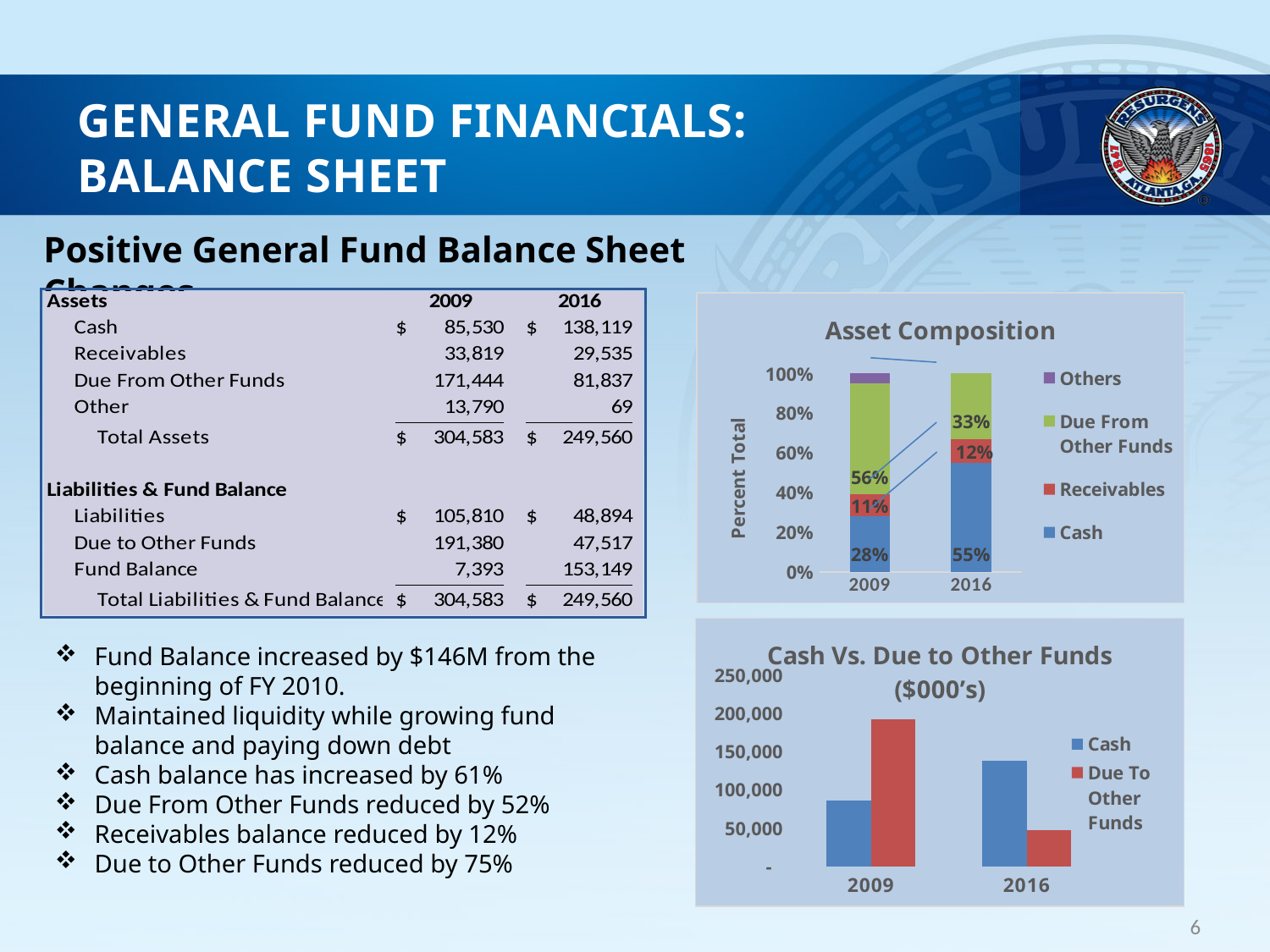
In the Cash Vs. Due to Other Funds chart, is the value for Cash in 2009 greater or less than 100,000? less In the Cash Vs. Due to Other Funds chart, which is larger in 2016, Cash or Due To Other Funds? Cash How many series does the legend of the Asset Composition chart list? 4 What is the y-axis label of the Asset Composition chart? Percent Total In the Cash Vs. Due to Other Funds chart, is the value for Due To Other Funds in 2009 greater or less than 150,000? greater In the Asset Composition chart, which year has the larger Due From Other Funds share, 2009 or 2016? 2009 In the Asset Composition chart, what percentage of total assets was Cash in 2009? 28% How many series does the legend of the Cash Vs. Due to Other Funds chart list? 2 In the Asset Composition chart, what percentage of total assets was Receivables in 2009? 11% What kind of chart is the Asset Composition chart? Stacked bar chart In the Asset Composition chart, what percentage of total assets was Due From Other Funds in 2016? 33% In the Asset Composition chart, by how many percentage points did the Cash share change from 2009 to 2016? 27 percentage points